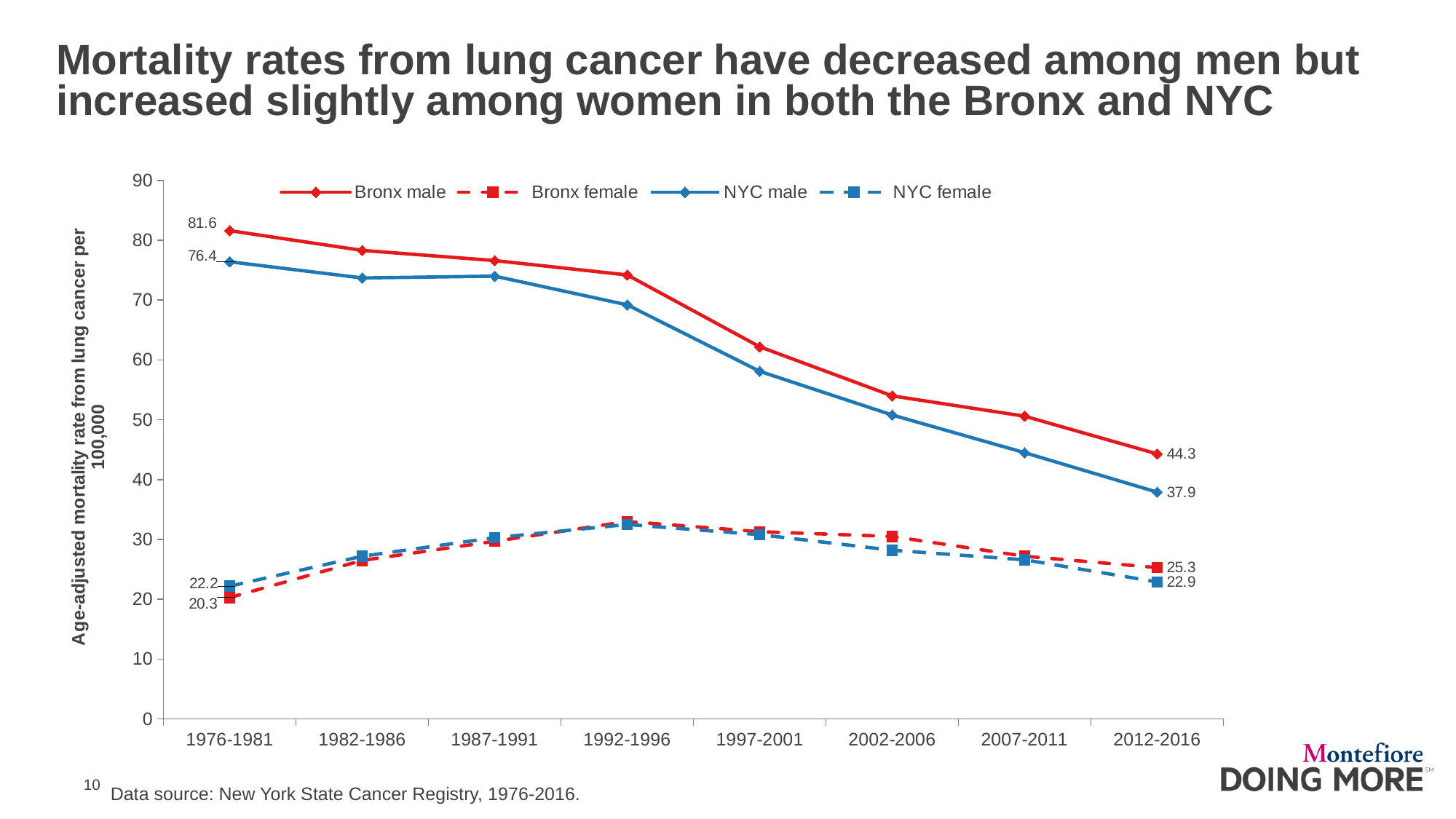
How many series does the legend list? 4 What is the NYC male lung cancer mortality rate for 2012-2016? 37.9 What is the difference between the Bronx female and NYC female mortality rates in 2012-2016? 2.4 By how much did the Bronx male mortality rate fall from 1976-1981 to 2012-2016? 37.3 What is the NYC female lung cancer mortality rate for 1976-1981? 22.2 In 2012-2016, which is larger: the Bronx male rate or the NYC male rate? Bronx male What is the Bronx male lung cancer mortality rate for 1976-1981? 81.6 What is the Bronx female lung cancer mortality rate for 2012-2016? 25.3 How many time periods are shown on the x axis? 8 Which series has the lowest value in 2012-2016? NYC female Which series has the highest value in 1976-1981? Bronx male Is the NYC male value for 1997-2001 greater or less than 60? less